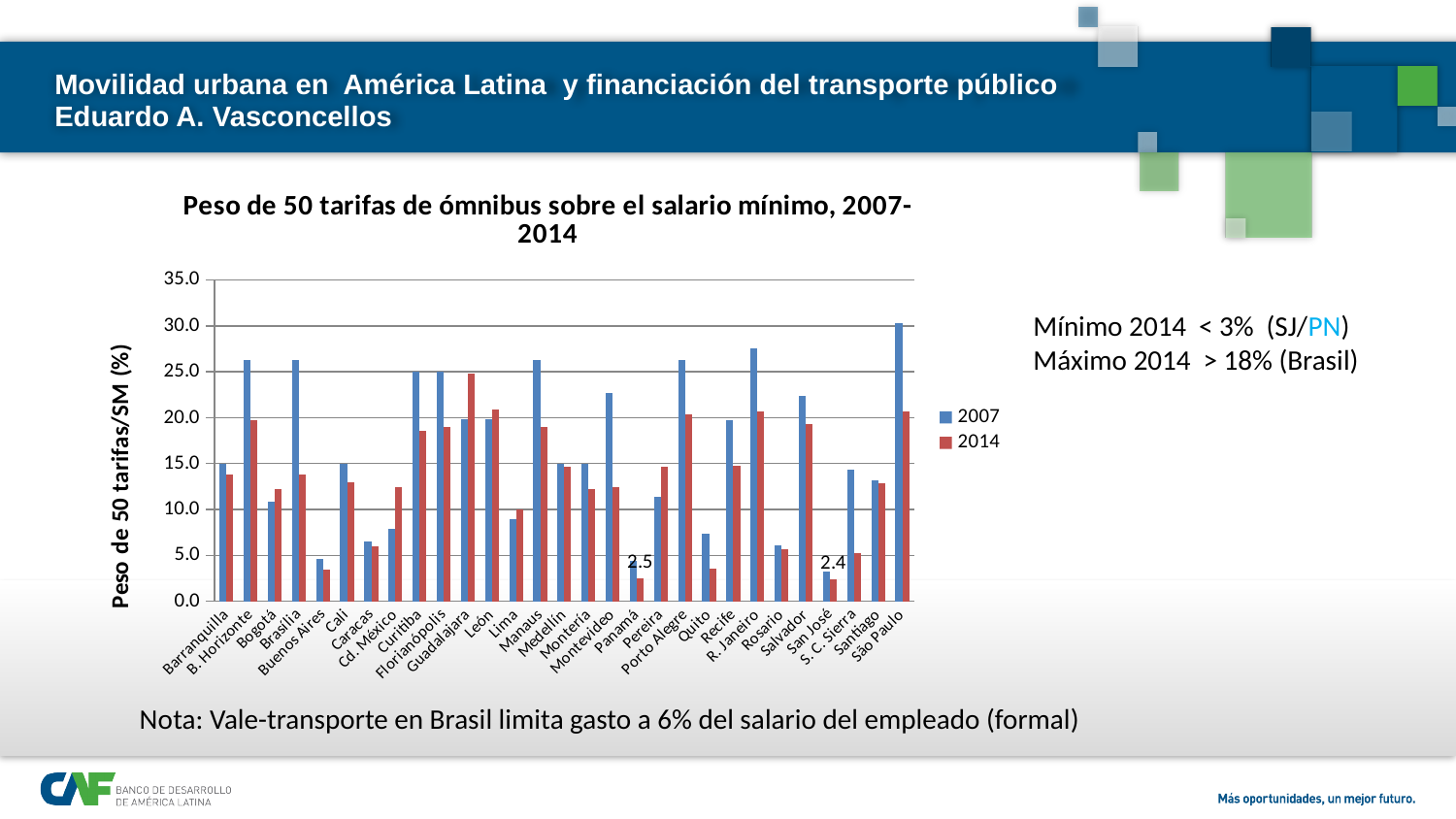
How many cities are shown on the x axis of the chart? 29 Which city has the highest 2007 value? São Paulo How many series does the legend list? 2 For Guadalajara, which is larger: the 2007 value or the 2014 value? 2014 What is the difference between the 2014 values for Panamá and San José? 0.1 What kind of chart is shown on the slide? bar chart What is the 2014 value for San José? 2.4 What is the 2014 value for Panamá? 2.5 Is the 2007 value for Brasilia greater or less than 25.0? greater What is the label of the y axis? Peso de 50 tarifas/SM (%) Which city has the lowest 2014 value? San José Is the 2007 value for Lima greater or less than 10.0? less